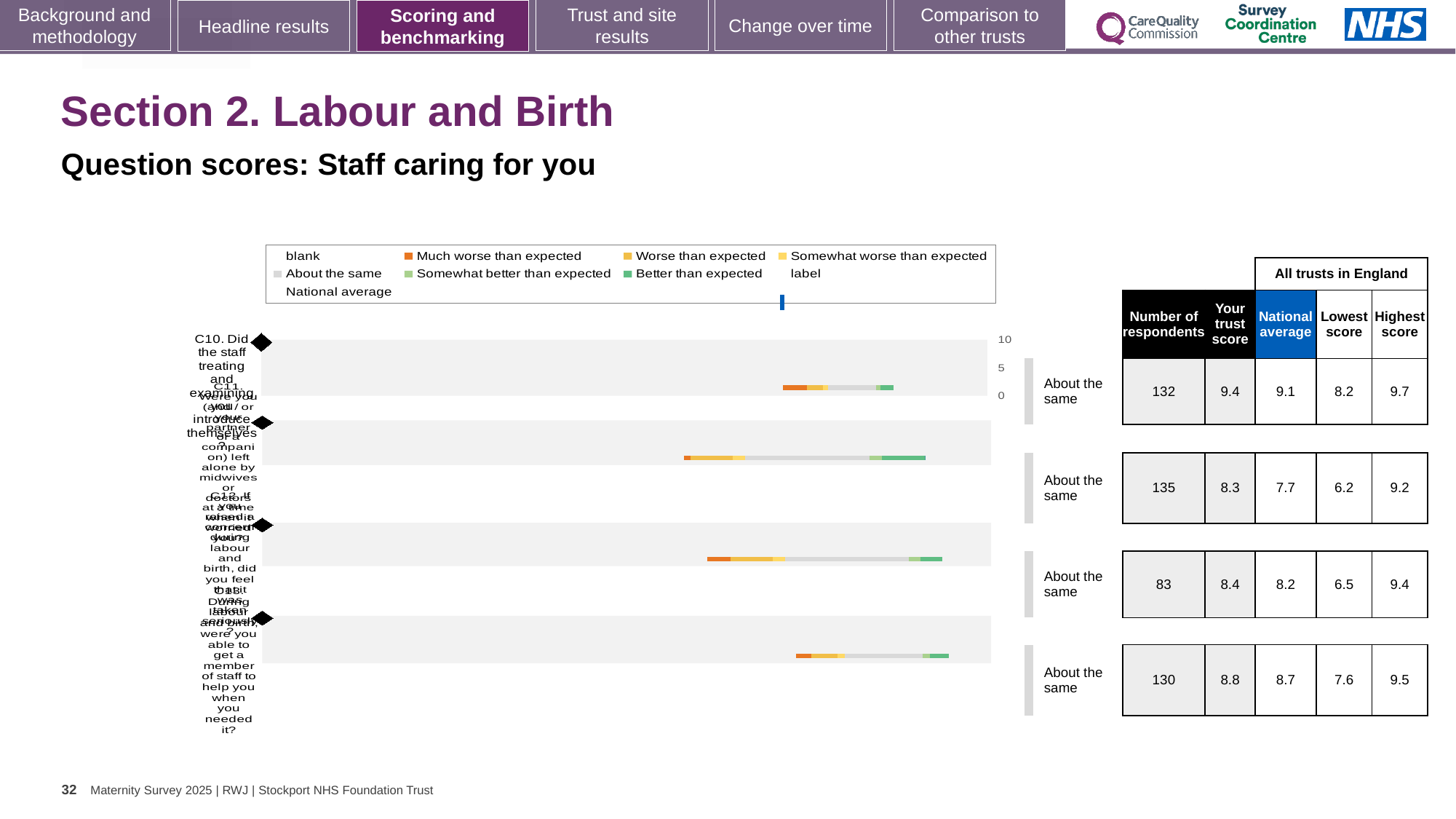
What is the difference between the trust score and the national average for the second question row? 0.6 According to the table beside the chart, what is the highest score among all trusts in England for the fourth (bottom) question row? 9.5 What colour does the legend use for 'Much worse than expected'? orange Is the trust score for the first question row larger or smaller than its national average? larger What kind of chart is shown on the slide? bar chart How many question rows (bars) are plotted in the chart? 4 Which question row has the highest number of respondents in the table beside the chart? the second row (135) According to the table beside the chart, how many respondents answered the third question row? 83 According to the table beside the chart, what is the trust score for the first (top) question row? 9.4 Which question row has the lowest 'Your trust score' in the table beside the chart? the second row (8.3) According to the table beside the chart, what is the national average for the second question row? 7.7 What benchmark category is shown next to every question row in the chart? About the same